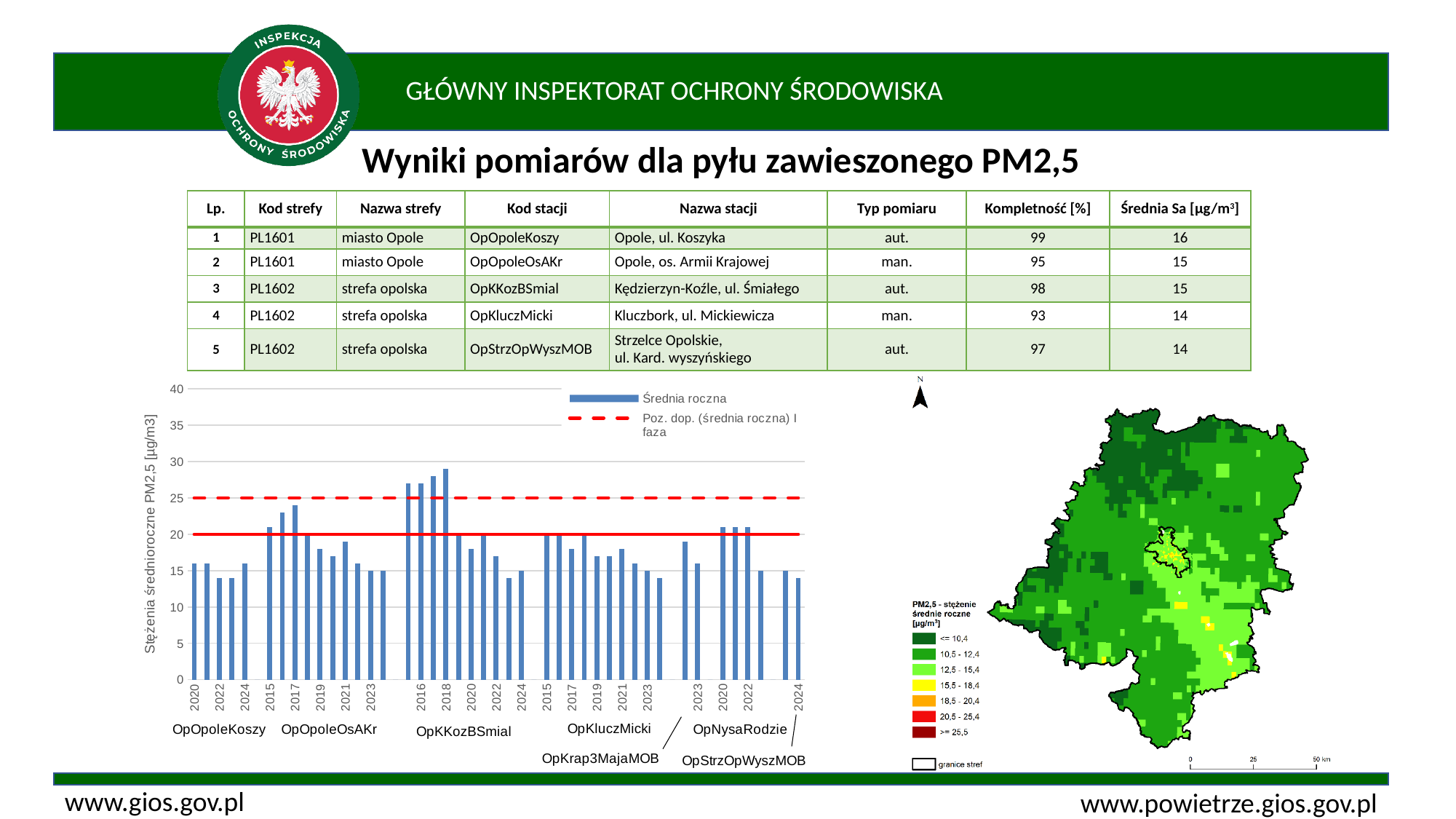
What are the two legend entries of the bar chart? Średnia roczna; Poz. dop. (średnia roczna) I faza In the bar chart, is the value for OpKKozBSmial in 2018 greater or less than 25? greater What kind of chart is shown at the bottom left of the slide? bar chart In the bar chart, do the bars for OpOpoleOsAKr rise or fall from 2015 to 2017? rise What is the y-axis label of the bar chart? Stężenia średnioroczne PM2,5 [µg/m3] At what level on the y-axis does the red dashed line (Poz. dop.) run in the bar chart? 25 In the bar chart, which is larger: the bar for OpKKozBSmial in 2018 or the bar for OpOpoleKoszy in 2020? OpKKozBSmial in 2018 In the bar chart, is the value for OpOpoleOsAKr in 2017 greater or less than 20? greater How many series does the legend of the bar chart list? 2 In the bar chart, is the value for OpOpoleKoszy in 2020 greater or less than 20? less How many station codes are labelled along the x-axis of the bar chart? 7 Which station has the highest bar in the bar chart? OpKKozBSmial